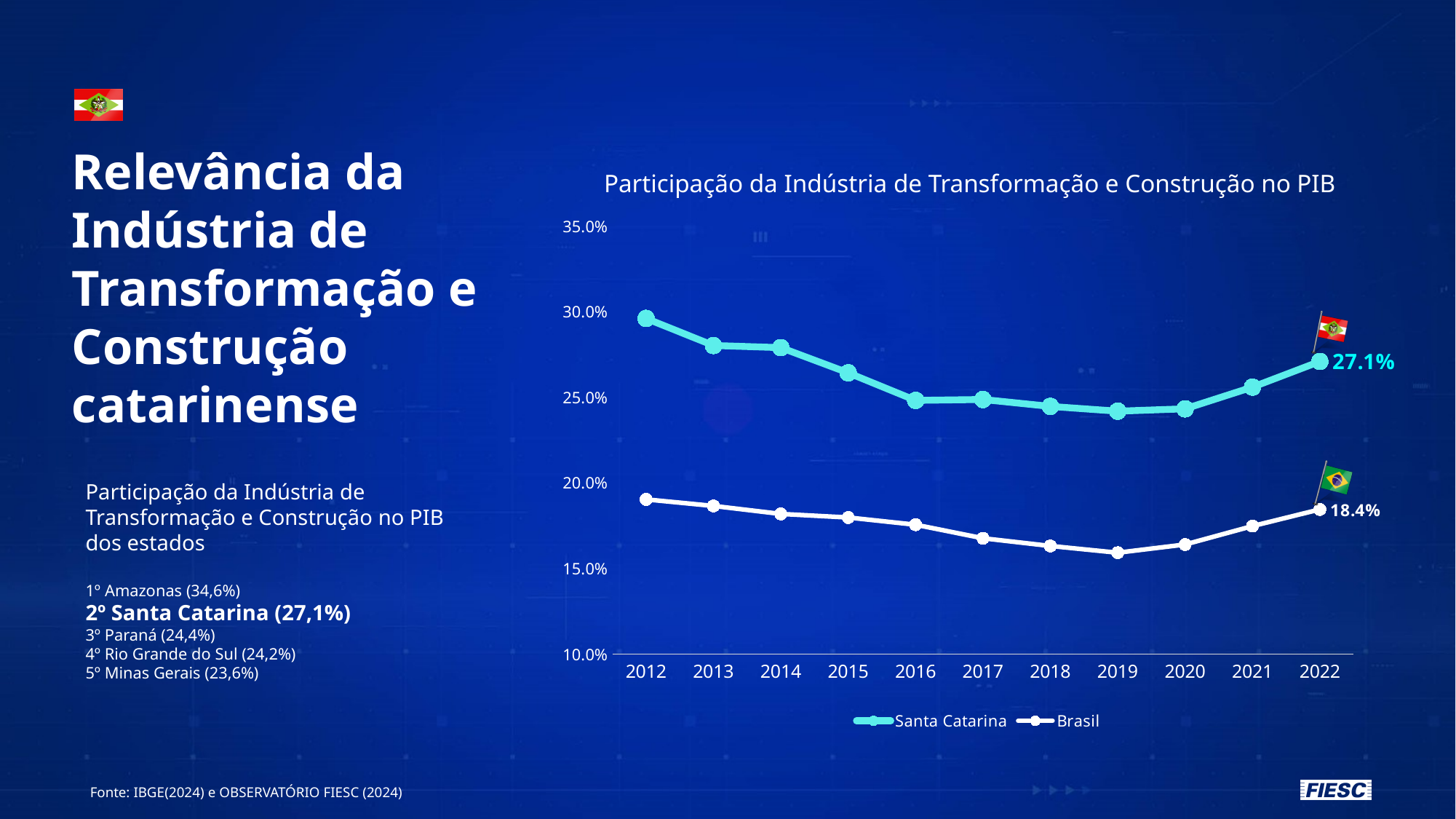
Is the value for Brasil in 2019 greater or less than 20.0%? less What is the difference between the Santa Catarina and Brasil values in 2022? 8.6% In 2022, which series has the larger value, Santa Catarina or Brasil? Santa Catarina Is the value for Santa Catarina in 2016 greater or less than 20.0%? greater What is the value for Brasil in 2022? 18.4% What is the value for Santa Catarina in 2022? 27.1% Is the value for Santa Catarina in 2012 greater or less than 25.0%? greater Does the Santa Catarina series rise or fall from 2019 to 2022? rise What kind of chart is shown on the slide? line chart How many series does the chart legend list? 2 In which year is the Santa Catarina series at its highest? 2012 How many years are shown on the x axis of the chart? 11